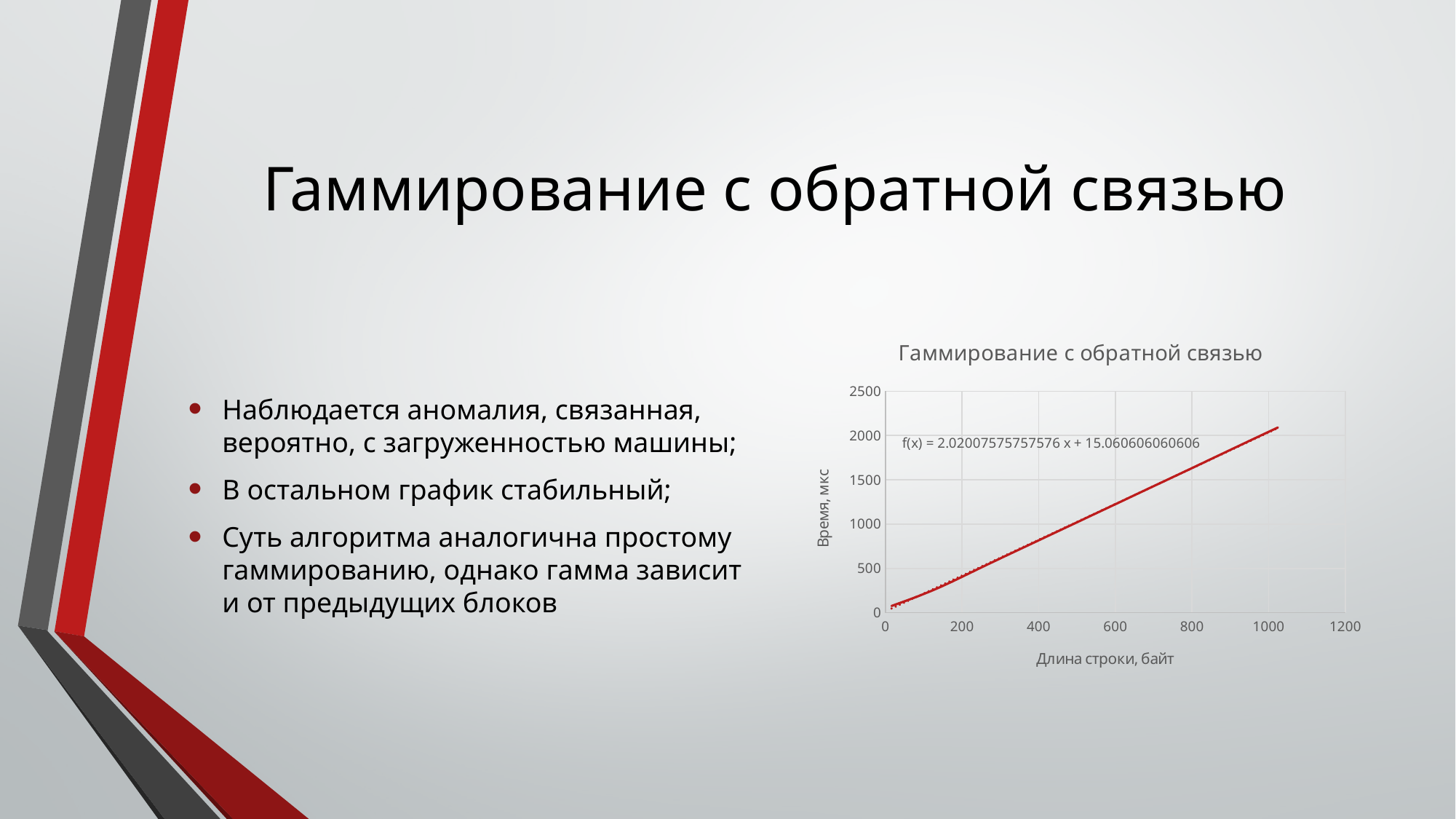
Is the value for a string length of 600 bytes greater or less than 1500? less What is the maximum value shown on the y axis of the chart? 2500 Is the value for a string length of 200 bytes greater or less than 500? less What kind of chart is shown on the slide? scatter chart What is the label of the x axis of the chart? Длина строки, байт What is the title of the chart? Гаммирование с обратной связью Do the plotted values rise or fall as the string length increases along the x axis? rise Is the value for a string length of 400 bytes greater or less than 500? greater